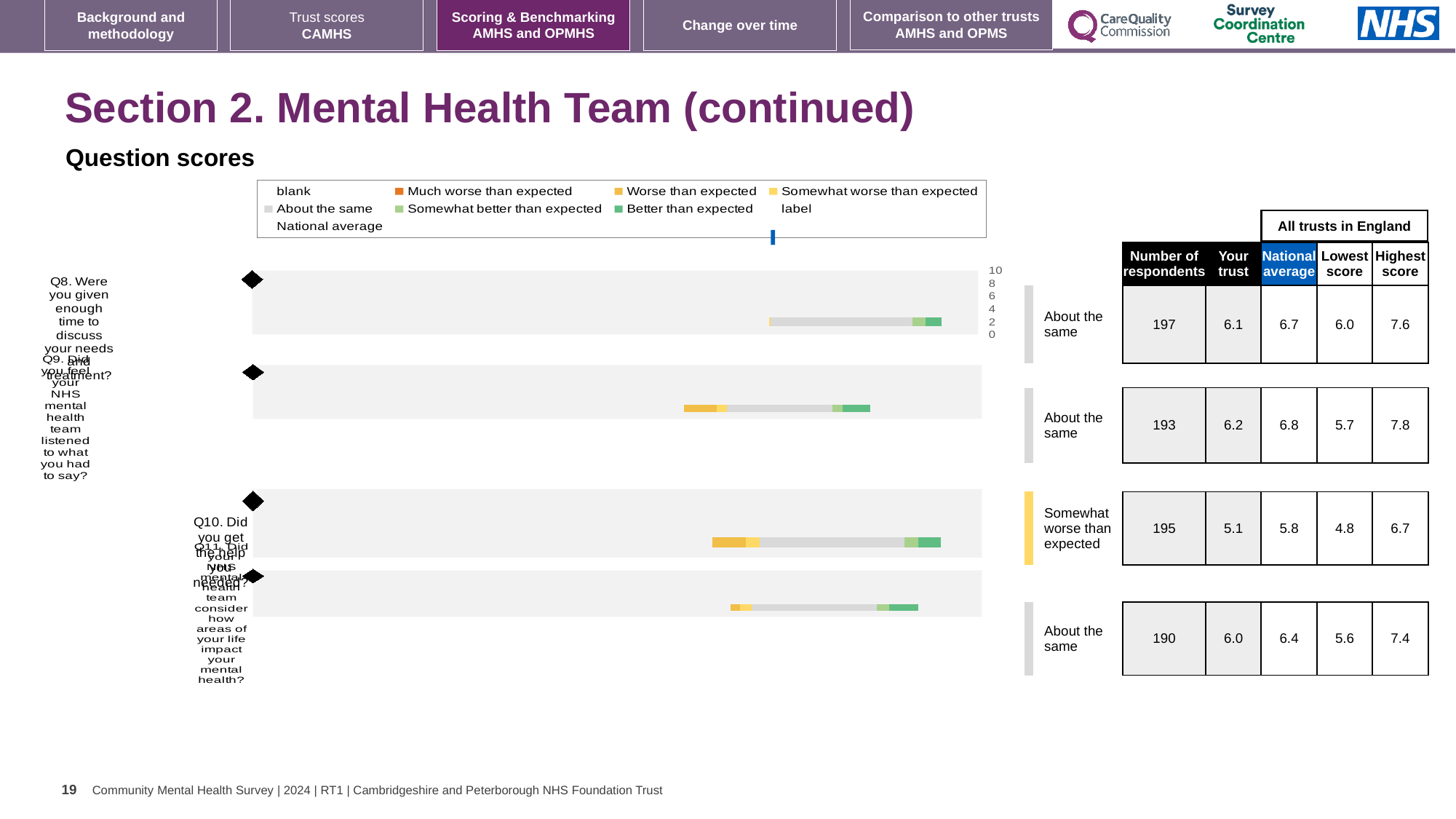
In the table beside the chart, which row has the lowest 'Your trust' score? third row (5.1) What kind of chart is shown under 'Question scores'? bar chart In the table beside the chart, what is the highest value in the 'Highest score' column? 7.8 In the table beside the chart, is the 'Your trust' score in the second row larger or smaller than the national average in that row? smaller How many questions (categories) are plotted in the chart? 4 What is the highest tick value shown on the chart's axis? 10 In the table beside the chart, what is the 'Your trust' score in the third row? 5.1 In the table beside the chart, what is the national average in the second row? 6.8 In the table beside the chart, what is the number of respondents in the first row? 197 In the table beside the chart, what is the difference between the national average and the 'Your trust' score in the first row? 0.6 In the chart legend, what colour represents 'Better than expected'? green What benchmark label is shown for the third row of the table? Somewhat worse than expected